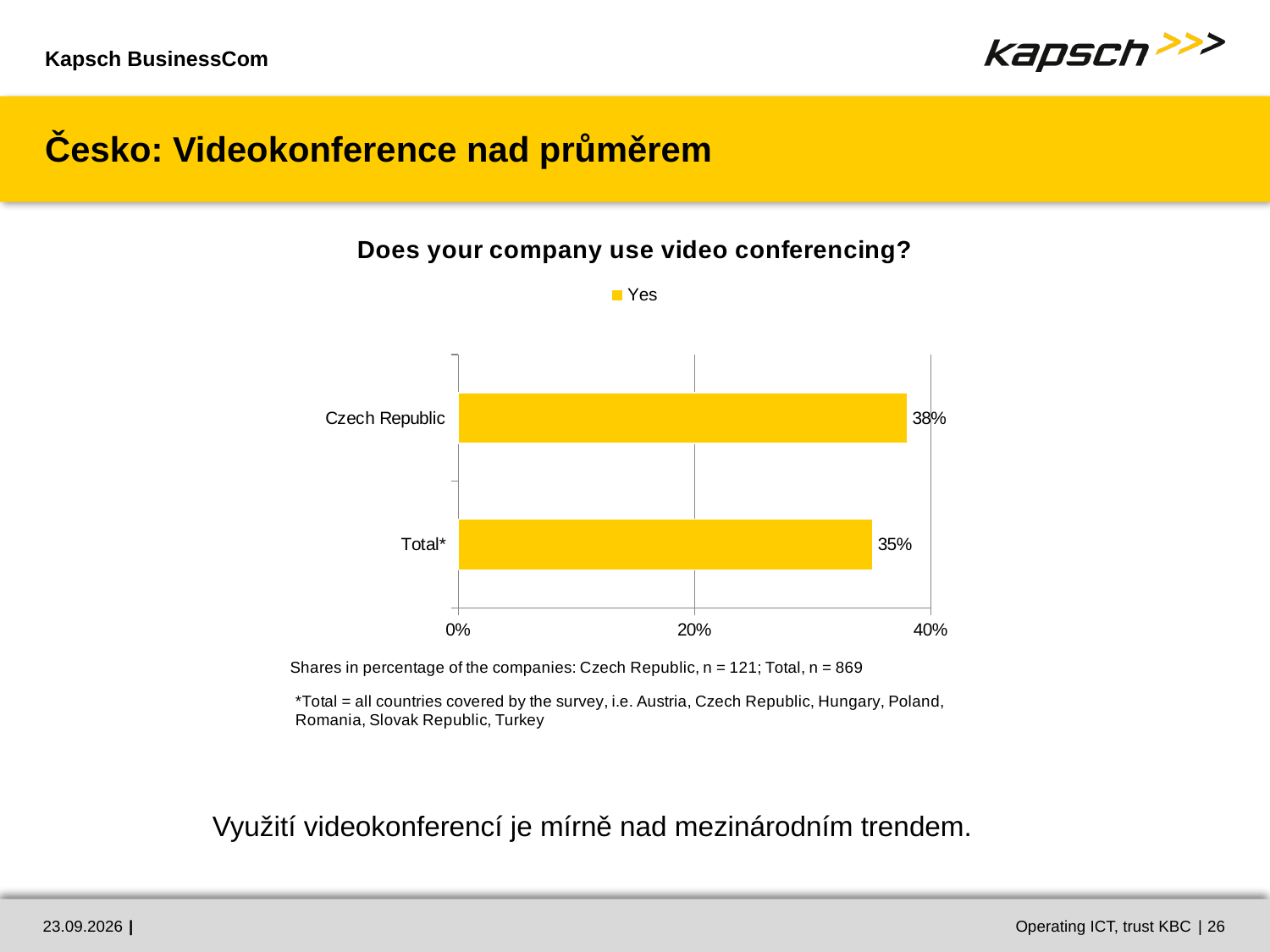
Which category has the lowest value? Total* What kind of chart is shown? Bar chart What is the value for Total*? 35% What is the difference between the Czech Republic value and the Total* value? 3% How many series does the legend list? 1 Which is larger, the value for Czech Republic or the value for Total*? Czech Republic Is the value for Czech Republic greater or less than 20%? greater What is the value for Czech Republic? 38% Which category has the highest value? Czech Republic How many categories are shown in the chart? 2 What is the title of the chart? Does your company use video conferencing? Is the value for Total* greater or less than 40%? less